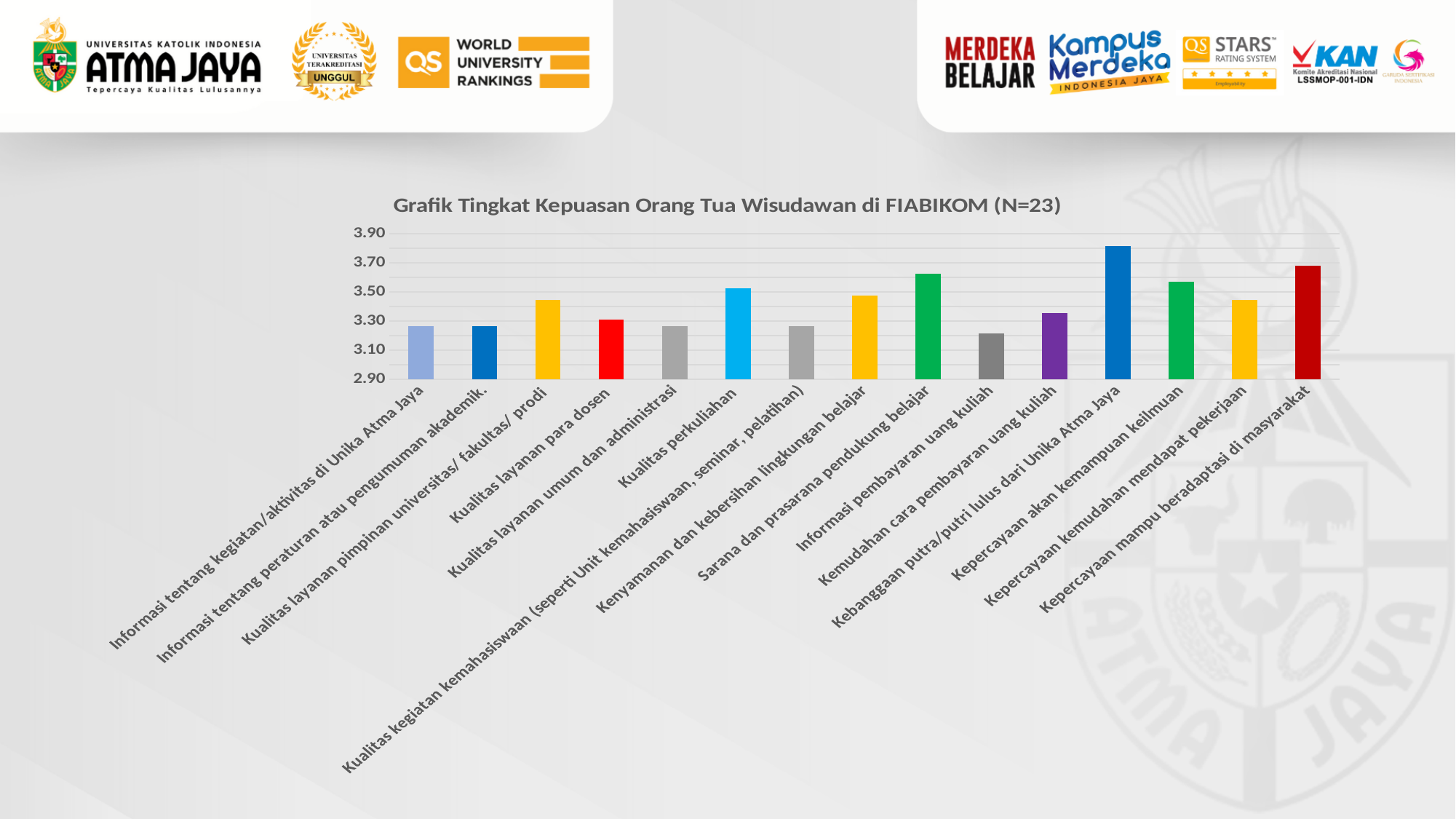
How many categories (bars) are plotted in the chart? 15 Which is larger: the value for Kepercayaan akan kemampuan keilmuan or the value for Kepercayaan kemudahan mendapat pekerjaan? Kepercayaan akan kemampuan keilmuan Is the value for Kualitas layanan pimpinan universitas/ fakultas/ prodi greater or less than 3.50? less What is the sample size (N) stated in the chart title? 23 Which is larger: the value for Sarana dan prasarana pendukung belajar or the value for Kualitas perkuliahan? Sarana dan prasarana pendukung belajar Is the value for Sarana dan prasarana pendukung belajar greater or less than 3.50? greater Which category has the lowest value in the chart? Informasi pembayaran uang kuliah What kind of chart is shown on the slide? Bar chart Is the value for Informasi pembayaran uang kuliah greater or less than 3.30? less Which category has the highest value in the chart? Kebanggaan putra/putri lulus dari Unika Atma Jaya What is the title of the chart? Grafik Tingkat Kepuasan Orang Tua Wisudawan di FIABIKOM (N=23)